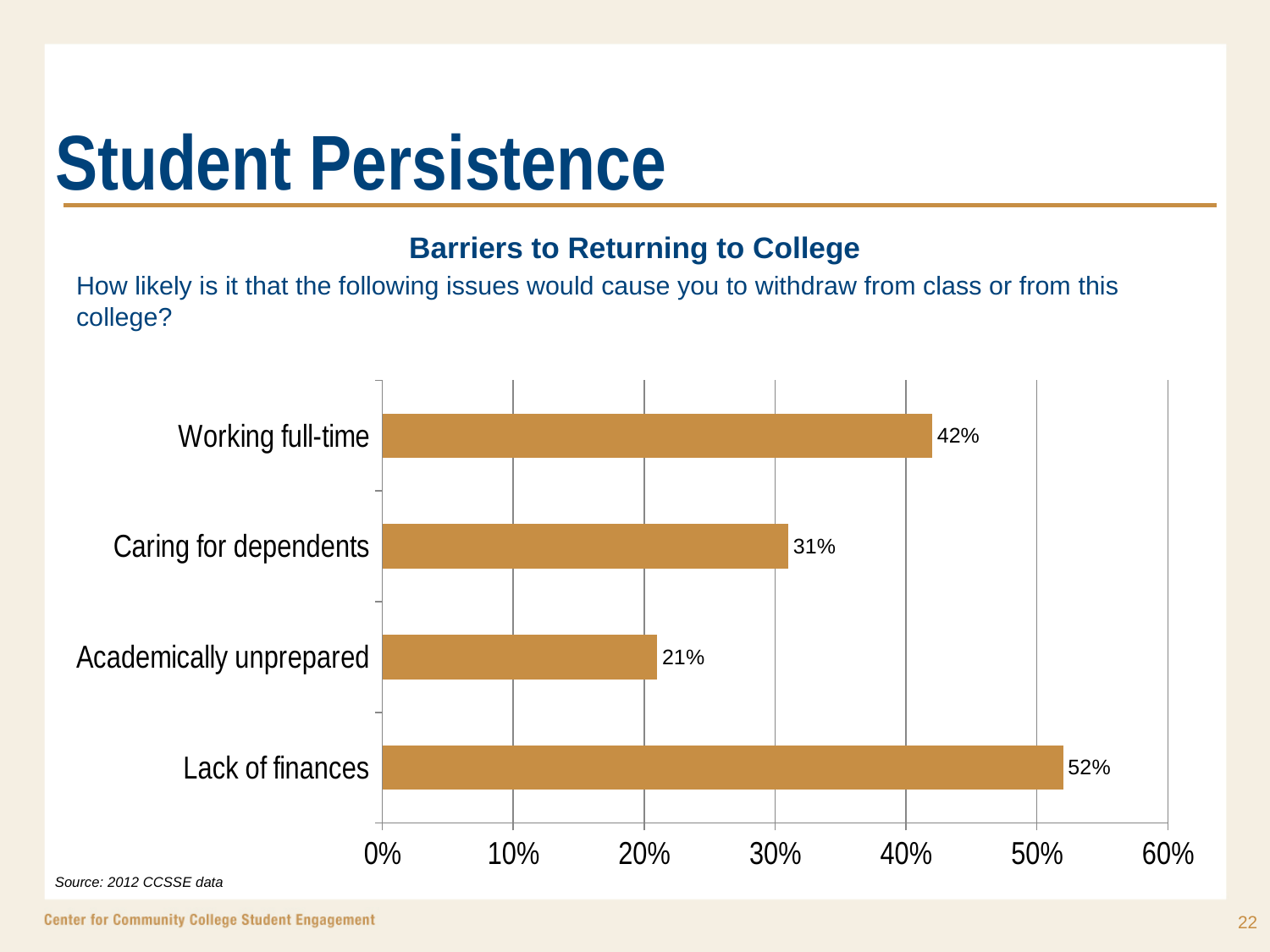
Which category has the highest value? Lack of finances What is the difference between the values for Caring for dependents and Academically unprepared? 10% Is the value for Lack of finances greater or less than 50%? greater Which category has the lowest value? Academically unprepared What kind of chart is shown on the slide? bar chart Which is larger, the value for Working full-time or the value for Caring for dependents? Working full-time What is the value for Caring for dependents? 31% What is the value for Academically unprepared? 21% What is the value for Lack of finances? 52% What is the difference between the values for Lack of finances and Working full-time? 10% How many categories are shown in the chart? 4 What is the value for Working full-time? 42%